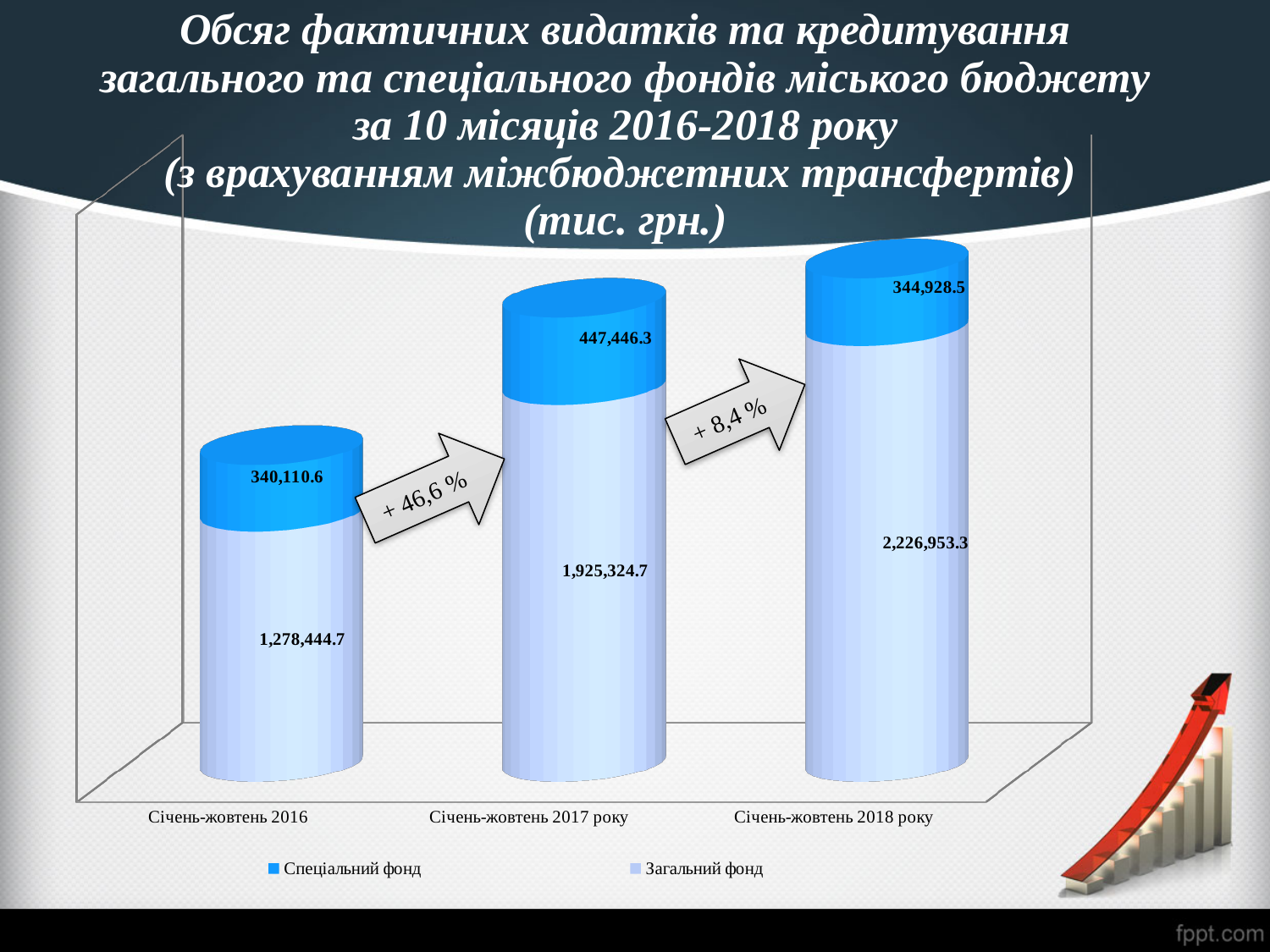
What percentage increase is shown by the arrow between Січень-жовтень 2016 and Січень-жовтень 2017 року? + 46,6 % What is the value of Загальний фонд for Січень-жовтень 2018 року? 2,226,953.3 What is the value of Спеціальний фонд for Січень-жовтень 2017 року? 447,446.3 How many series does the legend list? 2 What is the total of the stacked bar for Січень-жовтень 2016? 1,618,555.3 What is the value of Спеціальний фонд for Січень-жовтень 2016? 340,110.6 What is the total of the stacked bar for Січень-жовтень 2018 року? 2,571,881.8 Which period has the lowest value for Спеціальний фонд? Січень-жовтень 2016 What is the difference between Загальний фонд in Січень-жовтень 2018 року and Січень-жовтень 2017 року? 301,628.6 Which is larger: Спеціальний фонд in Січень-жовтень 2017 року or in Січень-жовтень 2018 року? Січень-жовтень 2017 року Which period has the highest value for Загальний фонд? Січень-жовтень 2018 року How many periods (categories) are shown on the x axis? 3